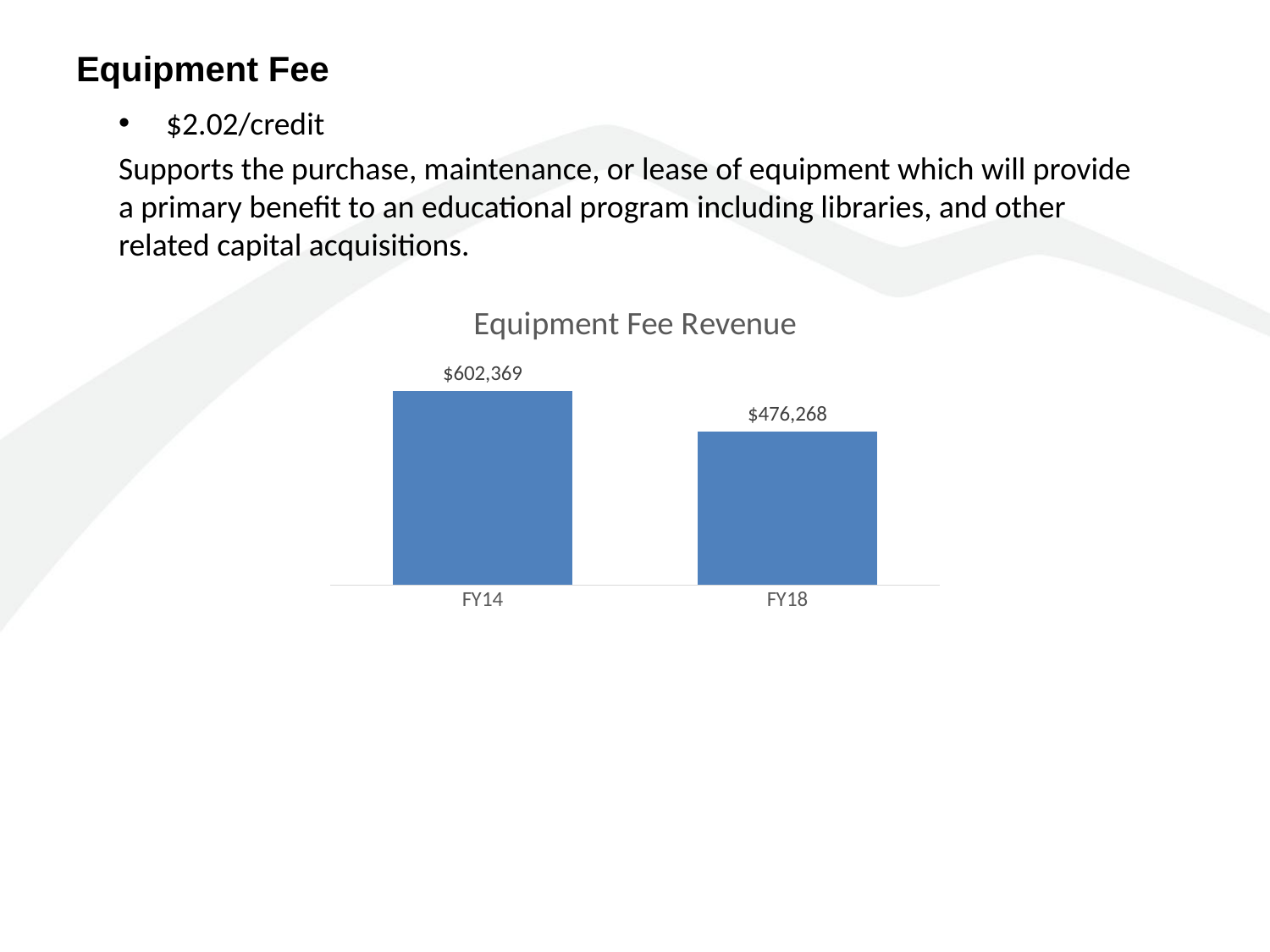
What is the Equipment Fee Revenue for FY18? $476,268 What is the Equipment Fee Revenue for FY14? $602,369 What is the difference between the FY14 and FY18 Equipment Fee Revenue? $126,101 Is the Equipment Fee Revenue larger in FY14 or FY18? FY14 Which fiscal year has the lower Equipment Fee Revenue? FY18 What colour are the bars in the Equipment Fee Revenue chart? Blue Does the Equipment Fee Revenue rise or fall from FY14 to FY18? Fall What is the title of the chart on the slide? Equipment Fee Revenue What type of chart is used to show Equipment Fee Revenue? Bar chart Which fiscal year has the higher Equipment Fee Revenue? FY14 How many fiscal years are shown in the Equipment Fee Revenue chart? 2